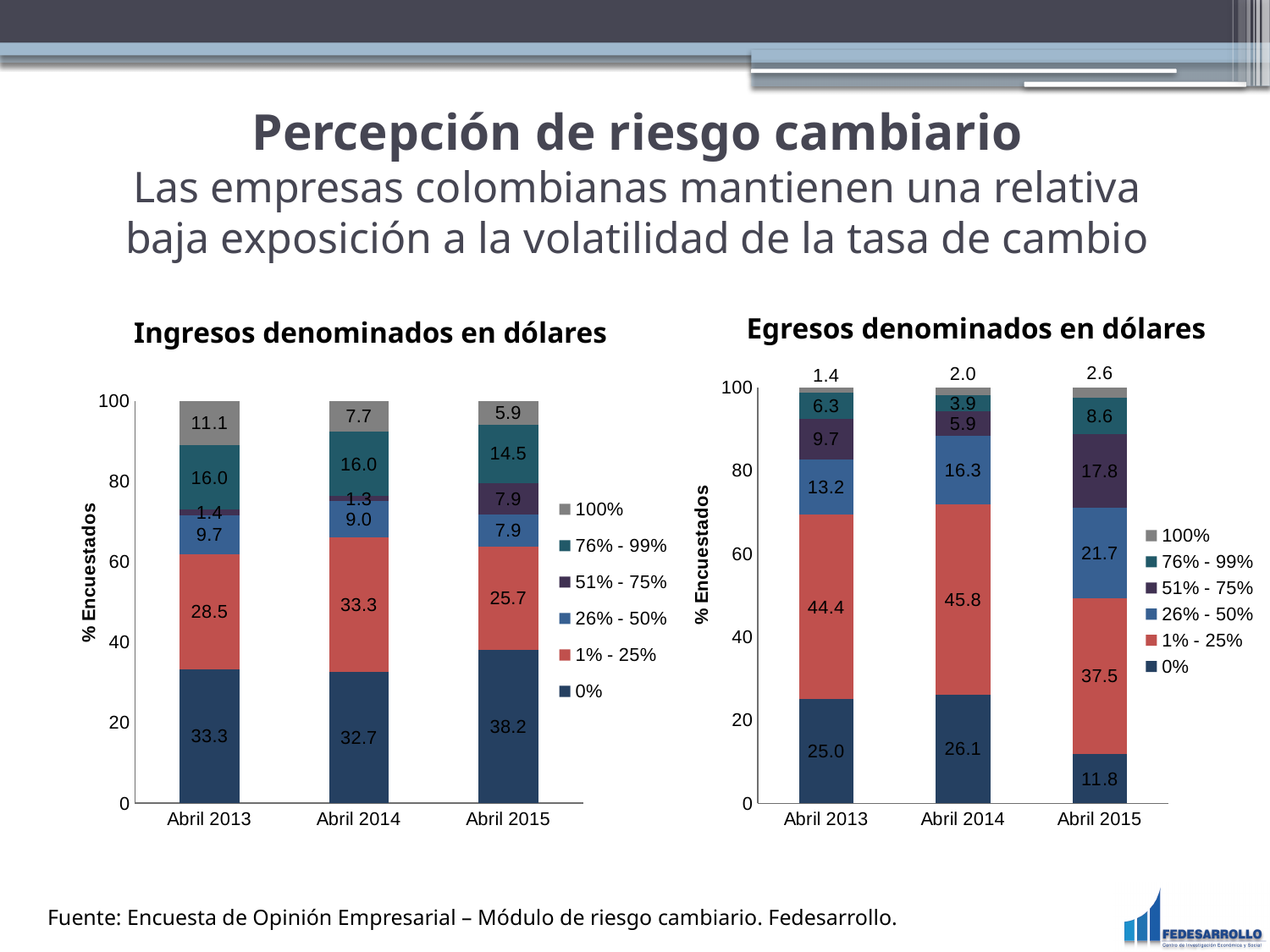
In the 'Egresos denominados en dólares' chart, which is larger: the 51% - 75% value for Abril 2013 or for Abril 2015? Abril 2015 In the 'Egresos denominados en dólares' chart, what is the value of the 1% - 25% series for Abril 2014? 45.8 How many series does the legend of the 'Ingresos denominados en dólares' chart list? 6 How many categories are shown on the x axis of the 'Egresos denominados en dólares' chart? 3 In the 'Ingresos denominados en dólares' chart, what is the value of the 100% series for Abril 2013? 11.1 In the 'Ingresos denominados en dólares' chart, what is the value of the 0% series for Abril 2015? 38.2 In the 'Ingresos denominados en dólares' chart, what is the difference between the 1% - 25% values for Abril 2014 and Abril 2015? 7.6 In the 'Egresos denominados en dólares' chart, does the 100% series rise or fall from Abril 2013 to Abril 2015? Rise In the 'Egresos denominados en dólares' chart, what is the value of the 26% - 50% series for Abril 2015? 21.7 In the 'Ingresos denominados en dólares' chart, which year has the highest value for the 0% series? Abril 2015 In the 'Egresos denominados en dólares' chart, which year has the lowest value for the 0% series? Abril 2015 What kind of chart is the 'Egresos denominados en dólares' chart? Stacked bar chart